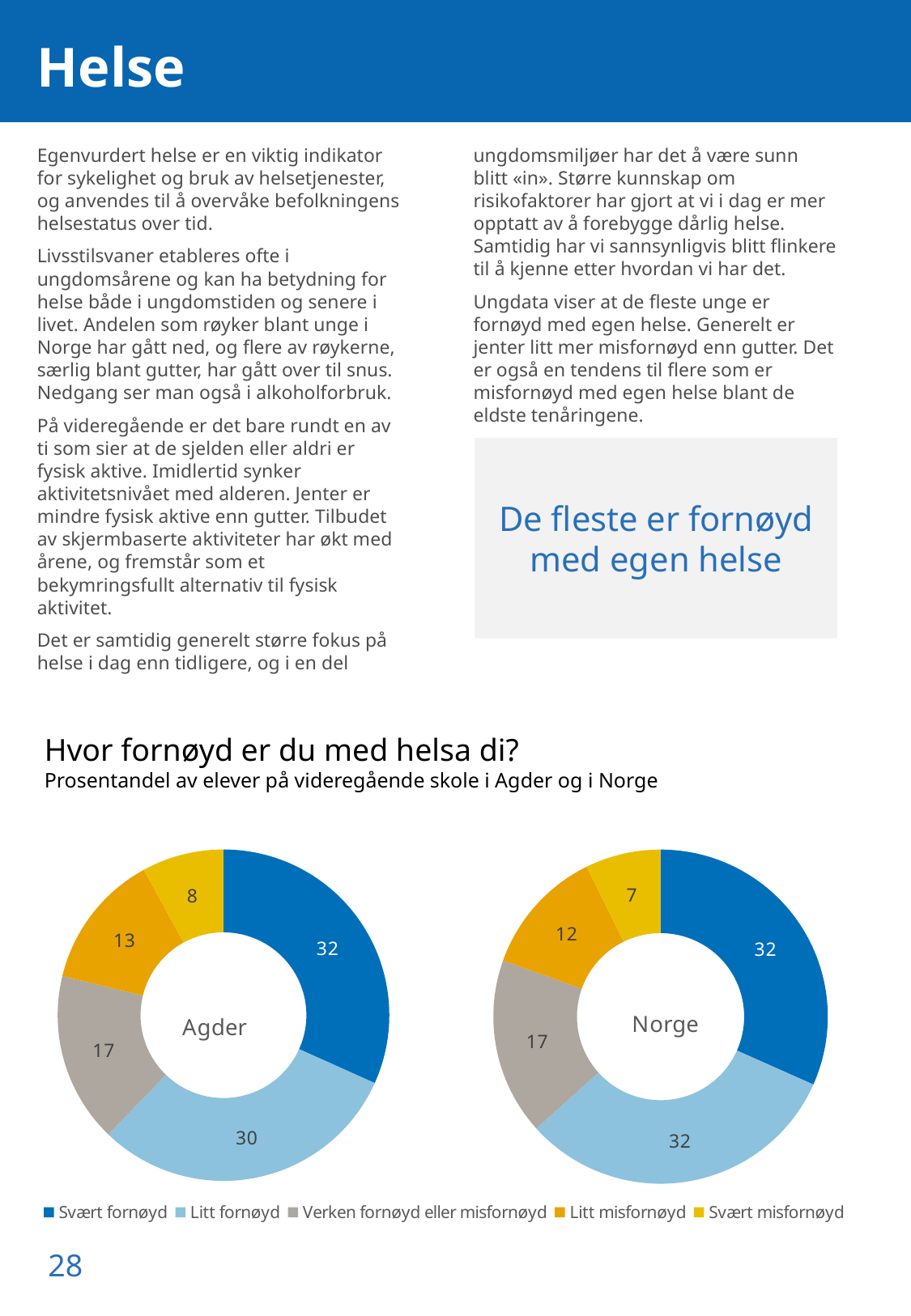
In the Norge chart, what is the value for Litt misfornøyd? 12 In the Norge chart, which category has the smallest value? Svært misfornøyd What kind of chart is used to show the Agder and Norge data? Doughnut (pie) chart In the Agder chart, what is the difference between Litt fornøyd and Litt misfornøyd? 17 In the Agder chart, what is the value for Verken fornøyd eller misfornøyd? 17 In the Agder chart, which category has the largest value? Svært fornøyd What is the title of the chart section on the slide? Hvor fornøyd er du med helsa di? Which is larger: Litt fornøyd in the Agder chart or Litt fornøyd in the Norge chart? Norge In the Norge chart, what is the value for Svært misfornøyd? 7 In the Agder chart, what is the value for Svært fornøyd? 32 In the Agder chart, which category has the smallest value? Svært misfornøyd How many categories does the legend list for the charts? 5